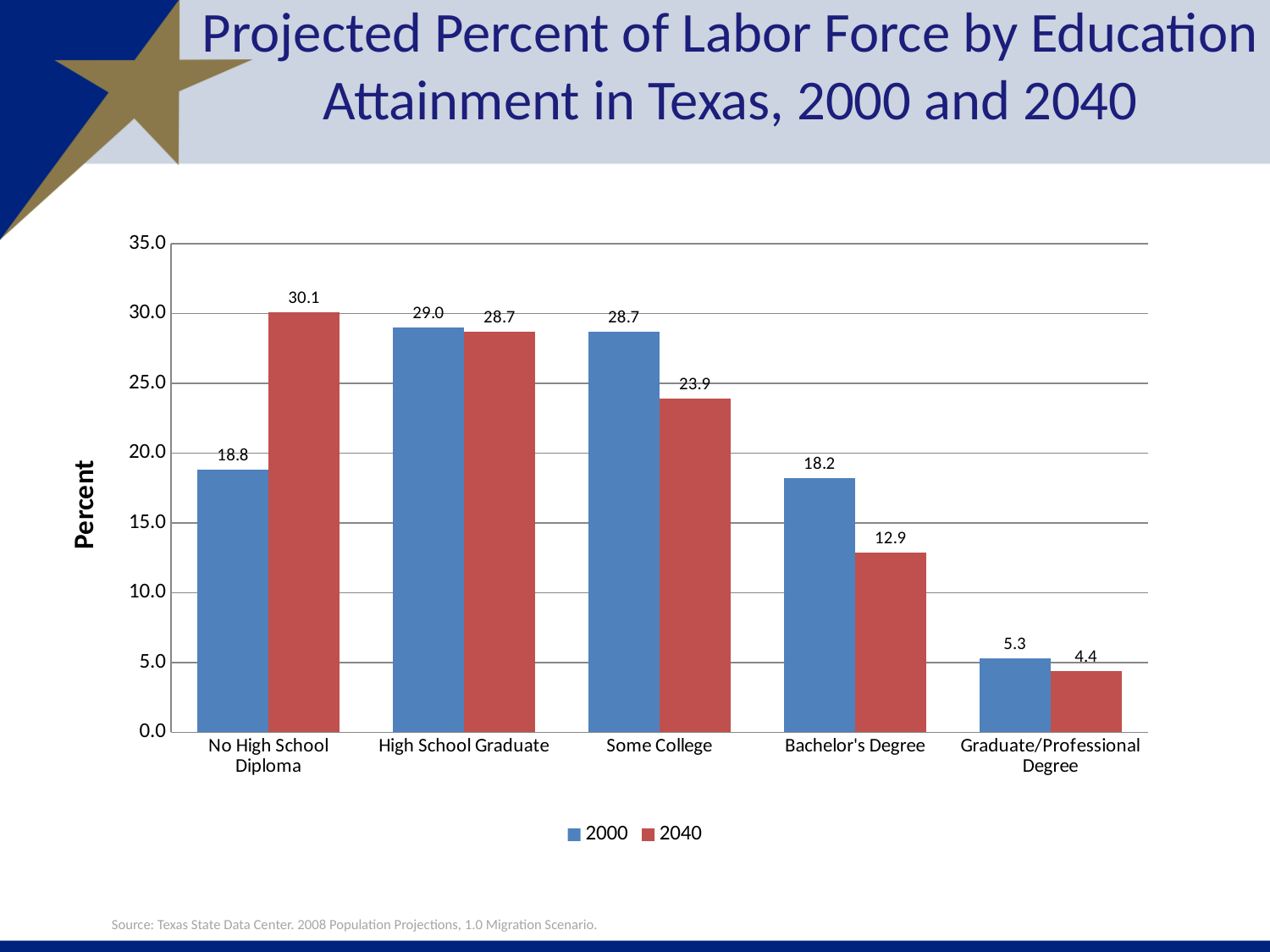
What kind of chart is shown on the slide? Bar chart What is the 2000 value for Bachelor's Degree? 18.2 Which is larger for Some College, the 2000 value or the 2040 value? 2000 How many series does the legend list? 2 What is the difference between the 2000 and 2040 values for Bachelor's Degree? 5.3 What is the 2040 value for No High School Diploma? 30.1 What is the label on the vertical axis? Percent What is the difference between the 2000 and 2040 values for No High School Diploma? 11.3 Which category has the lowest 2000 value? Graduate/Professional Degree How many education categories are shown on the x axis? 5 What is the 2040 value for Some College? 23.9 Which category has the highest 2040 value? No High School Diploma